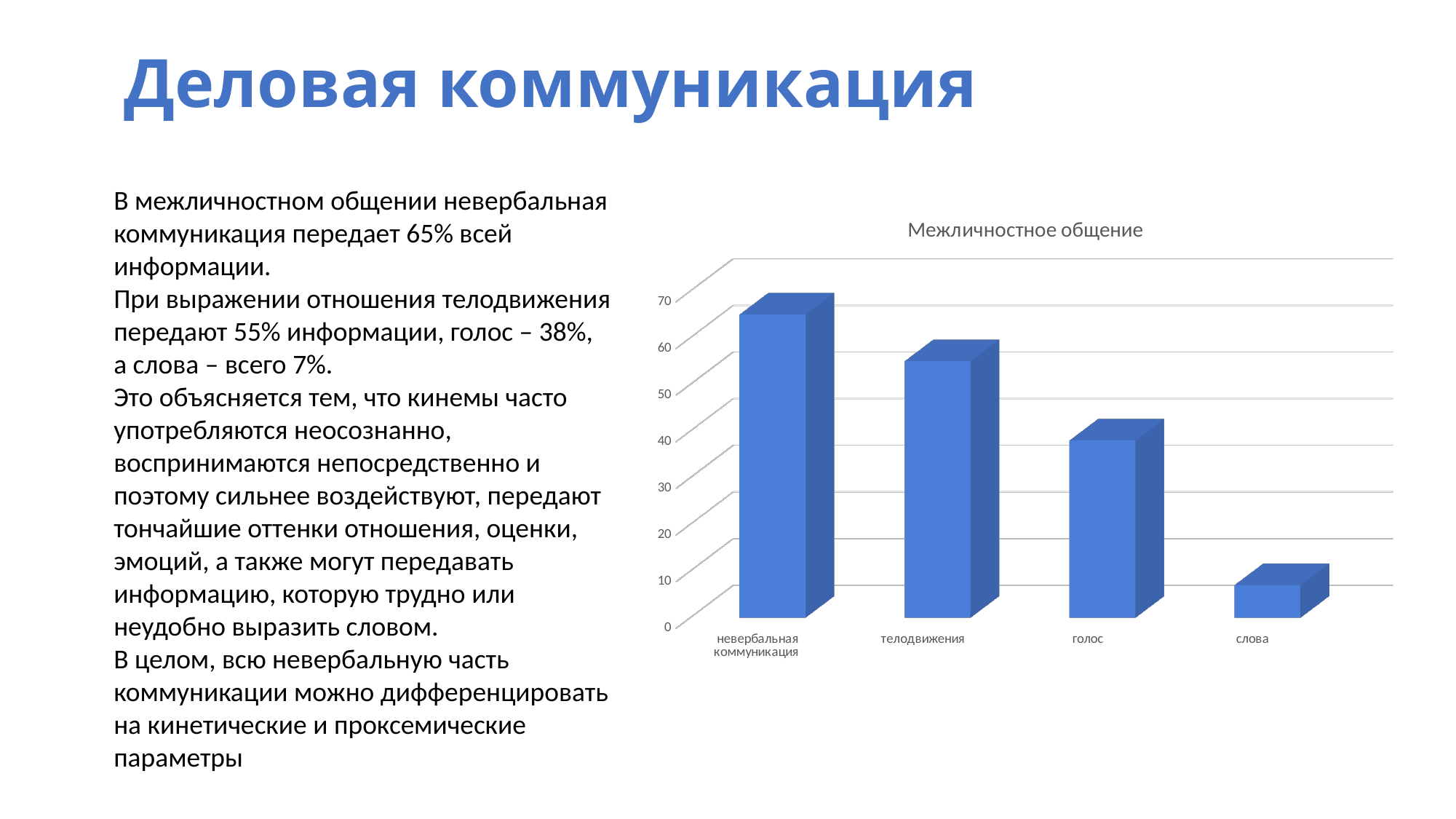
Which is larger, the value for телодвижения or the value for голос? телодвижения Is the value for слова greater or less than 10? less Which is larger, the value for голос or the value for слова? голос Which category has the lowest bar in the chart? слова Which category has the highest bar in the chart? невербальная коммуникация Do the bar values rise or fall from left to right along the x axis? fall Is the value for невербальная коммуникация greater or less than 60? greater How many categories are shown on the x axis of the chart? 4 What is the title of the chart? Межличностное общение Is the value for телодвижения greater or less than 50? greater What kind of chart is shown on the slide? bar chart